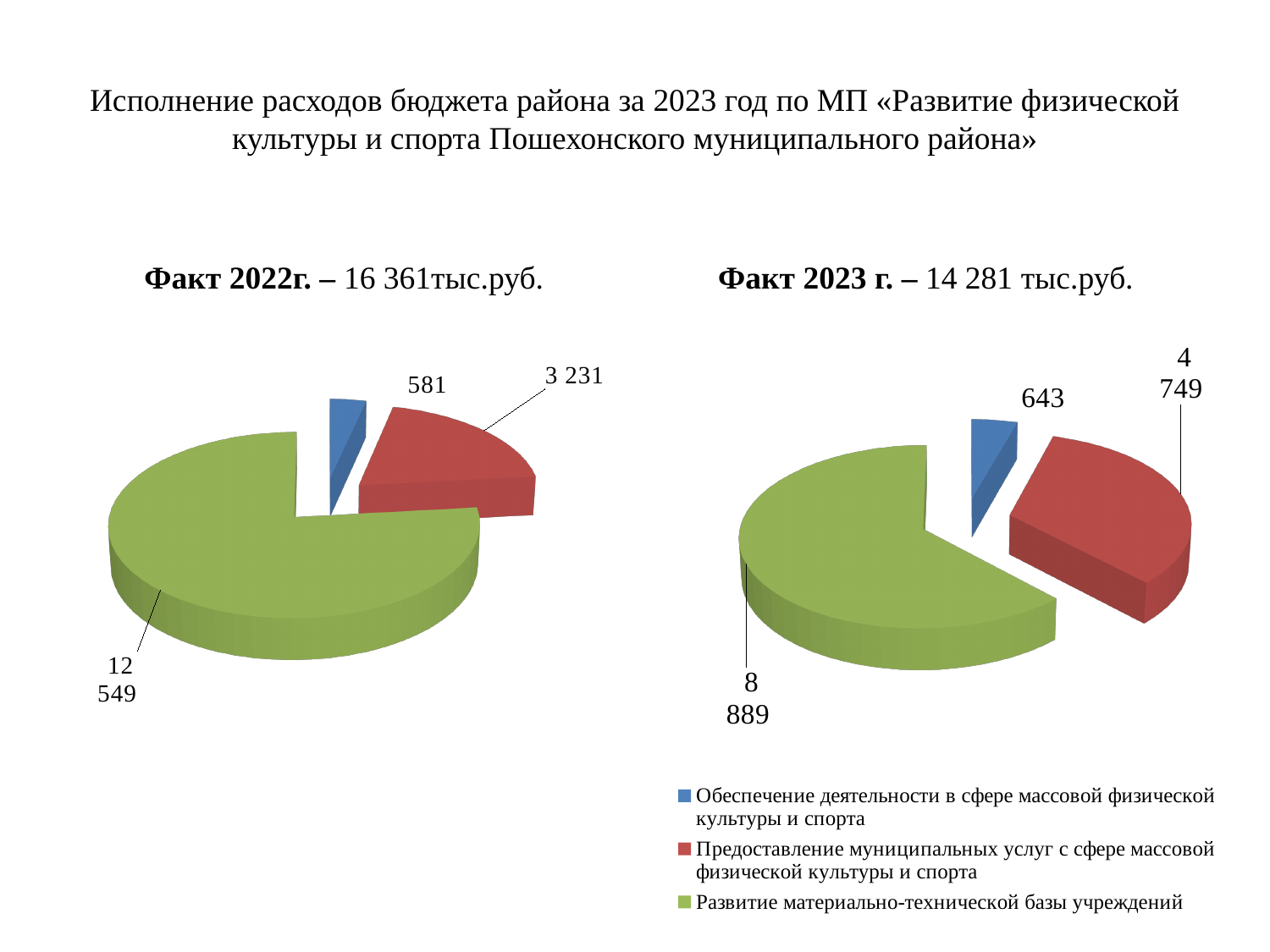
In the 'Факт 2022г.' pie chart, which category has the smallest slice? Обеспечение деятельности в сфере массовой физической культуры и спорта What is the difference between the 'Развитие материально-технической базы учреждений' value in the 'Факт 2022г.' chart and in the 'Факт 2023 г.' chart? 3 660 Which chart shows a larger value for 'Предоставление муниципальных услуг с сфере массовой физической культуры и спорта', 'Факт 2022г.' or 'Факт 2023 г.'? Факт 2023 г. In the 'Факт 2023 г.' pie chart, which category has the largest slice? Развитие материально-технической базы учреждений How many slices does the 'Факт 2023 г.' pie chart have? 3 In the 'Факт 2023 г.' pie chart, what is the value for 'Развитие материально-технической базы учреждений'? 8 889 In the 'Факт 2022г.' pie chart, what is the value for 'Развитие материально-технической базы учреждений'? 12 549 Which colour represents 'Развитие материально-технической базы учреждений' in the legend? Green What kind of chart is used for 'Факт 2022г.'? Pie chart In the 'Факт 2022г.' pie chart, what is the difference between the values for 'Предоставление муниципальных услуг с сфере массовой физической культуры и спорта' and 'Обеспечение деятельности в сфере массовой физической культуры и спорта'? 2 650 In the 'Факт 2022г.' pie chart, what is the value for 'Обеспечение деятельности в сфере массовой физической культуры и спорта'? 581 In the 'Факт 2023 г.' pie chart, what is the value for 'Предоставление муниципальных услуг с сфере массовой физической культуры и спорта'? 4 749